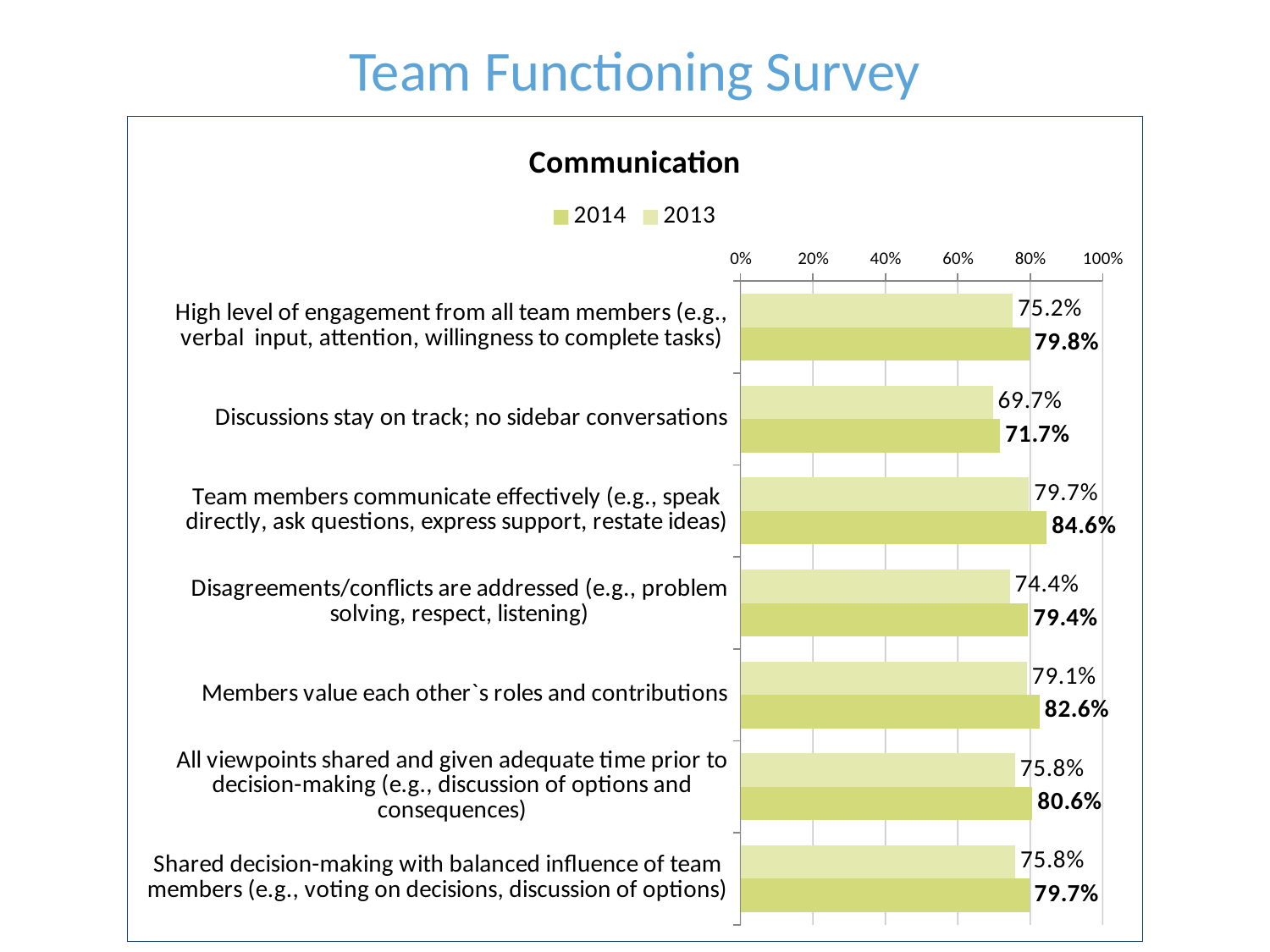
Which is larger for "All viewpoints shared and given adequate time prior to decision-making": the 2014 value or the 2013 value? 2014 Which category has the highest 2014 value? Team members communicate effectively What kind of chart is shown on the slide? Bar chart What is the 2013 value for "Disagreements/conflicts are addressed"? 74.4% How many series does the legend list? 2 What is the 2014 value for "Members value each other`s roles and contributions"? 82.6% What is the 2014 value for "Team members communicate effectively"? 84.6% What is the 2013 value for "Discussions stay on track; no sidebar conversations"? 69.7% What is the title of the chart? Communication Which category has the lowest 2013 value? Discussions stay on track; no sidebar conversations What is the difference between the 2014 and 2013 values for "High level of engagement from all team members"? 4.6% How many categories are shown in the chart? 7